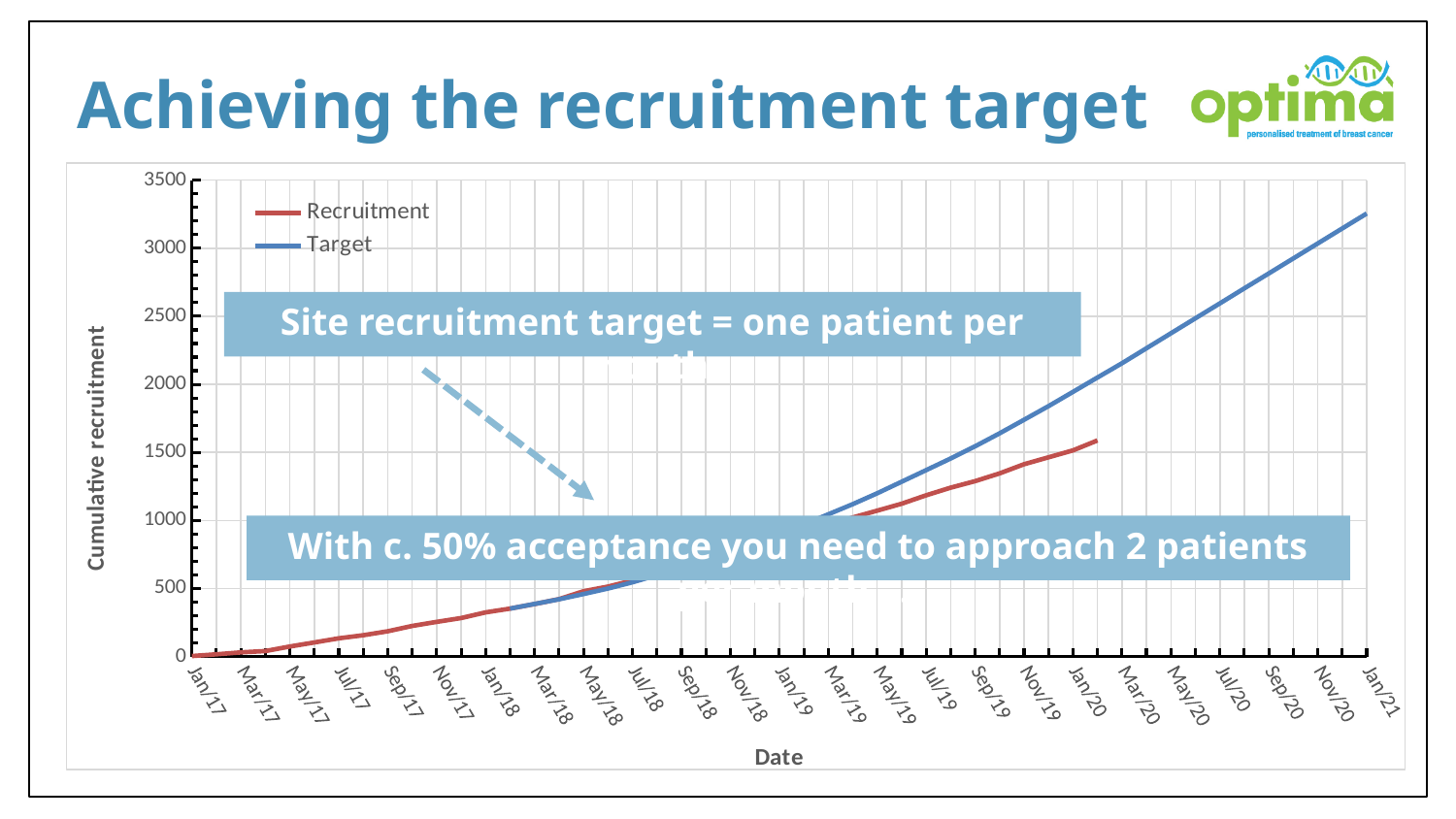
What is the last date label shown on the x axis of the chart? Jan/21 What kind of chart is shown on the slide? Line chart How many series does the chart legend list? 2 Is the value of the Target line at Jan/21 greater or less than 3000? greater Which series extends further along the x axis, Recruitment or Target? Target Do the values of the Target line rise or fall from Jan/17 to Jan/21? Rise What is the highest value shown on the vertical axis of the chart? 3500 What is the title of the vertical axis of the chart? Cumulative recruitment Is the value of the Recruitment line at Jan/20 greater or less than 2000? less What are the two series named in the chart legend? Recruitment and Target At Jan/20, which line is higher, Target or Recruitment? Target Is the value of the Target line at Jan/20 greater or less than 1500? greater